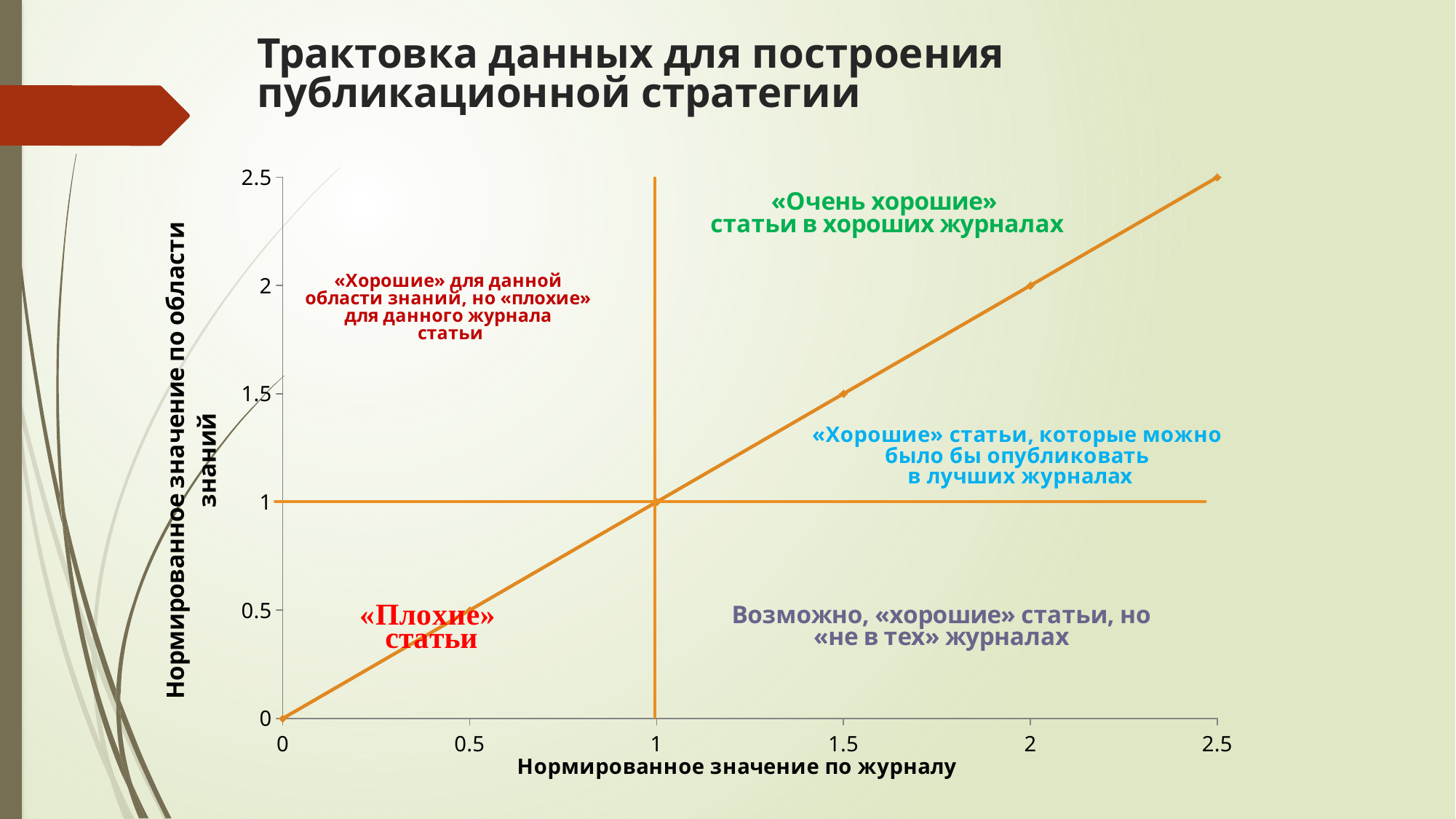
Как подписана горизонтальная ось диаграммы? Нормированное значение по журналу Значение диагональной линии при 2.5 по горизонтальной оси больше или меньше 2? больше Какое максимальное значение показано на вертикальной оси? 2.5 Какое максимальное значение показано на горизонтальной оси? 2.5 На каком уровне вертикальной оси проходит горизонтальная линия, делящая диаграмму на квадранты? 1 Какое значение по вертикальной оси имеет точка диагональной линии при значении 2 по горизонтальной оси? 2 Как подписана вертикальная ось диаграммы? Нормированное значение по области знаний Какой тип диаграммы показан на слайде? Линейная диаграмма Какое значение по вертикальной оси имеет точка диагональной линии при значении 1.5 по горизонтальной оси? 1.5 Какое значение по вертикальной оси имеет точка диагональной линии при значении 0 по горизонтальной оси? 0 Растёт или падает диагональная линия при движении слева направо по горизонтальной оси? Растёт